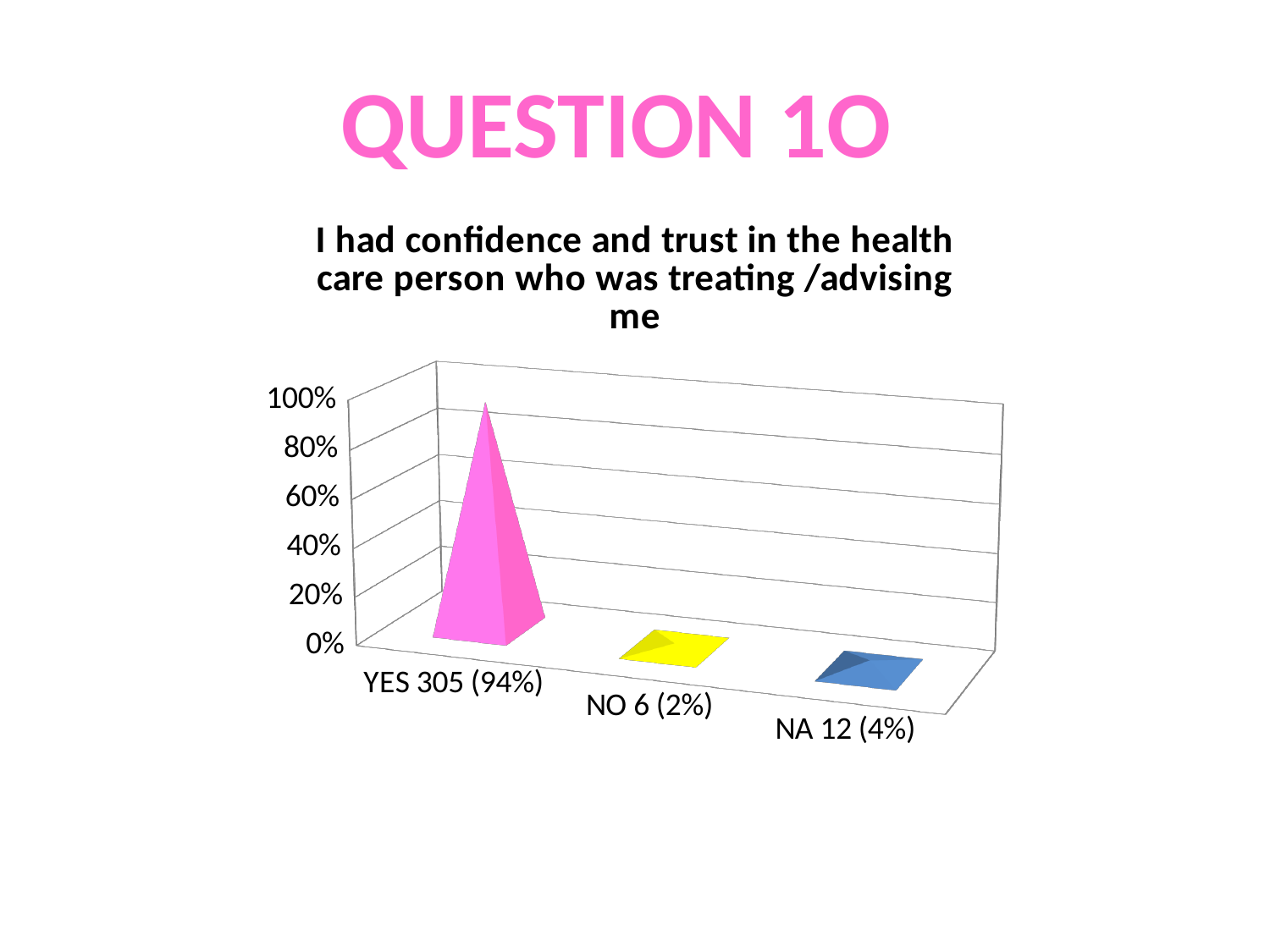
What percentage of respondents answered YES? 94% Which is larger, the value for NA or the value for NO? NA What percentage of respondents answered NA? 4% How many categories are shown on the chart? 3 What kind of chart is shown on the slide? Bar chart Which category has the lowest value? NO Is the value for YES greater or less than 80%? greater What colour is the bar for YES? Pink What is the difference in percentage points between YES and NO? 92% Is the value for NA greater or less than 20%? less Which category has the highest value? YES How many respondents answered NO? 6